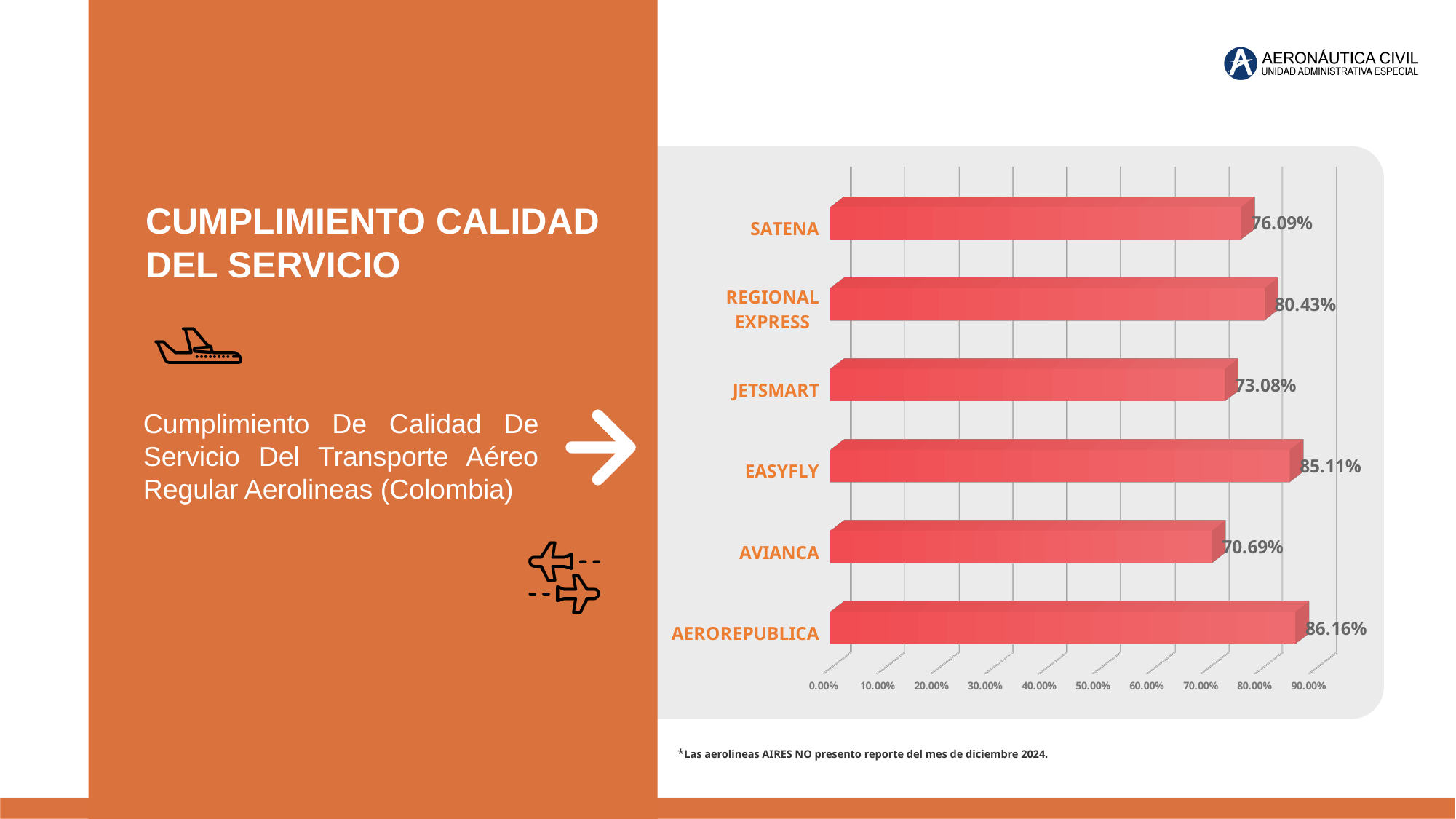
What is the value for SATENA? 76.09% What is the value for AEROREPUBLICA? 86.16% What is the value for REGIONAL EXPRESS? 80.43% What is the value for AVIANCA? 70.69% Which airline has the highest value? AEROREPUBLICA What is the difference between the values for AEROREPUBLICA and AVIANCA? 15.47% What is the value for EASYFLY? 85.11% How many airlines are shown in the chart? 6 What kind of chart is shown on the slide? Bar chart Which is larger, the value for REGIONAL EXPRESS or the value for SATENA? REGIONAL EXPRESS Which airline has the lowest value? AVIANCA What is the value for JETSMART? 73.08%